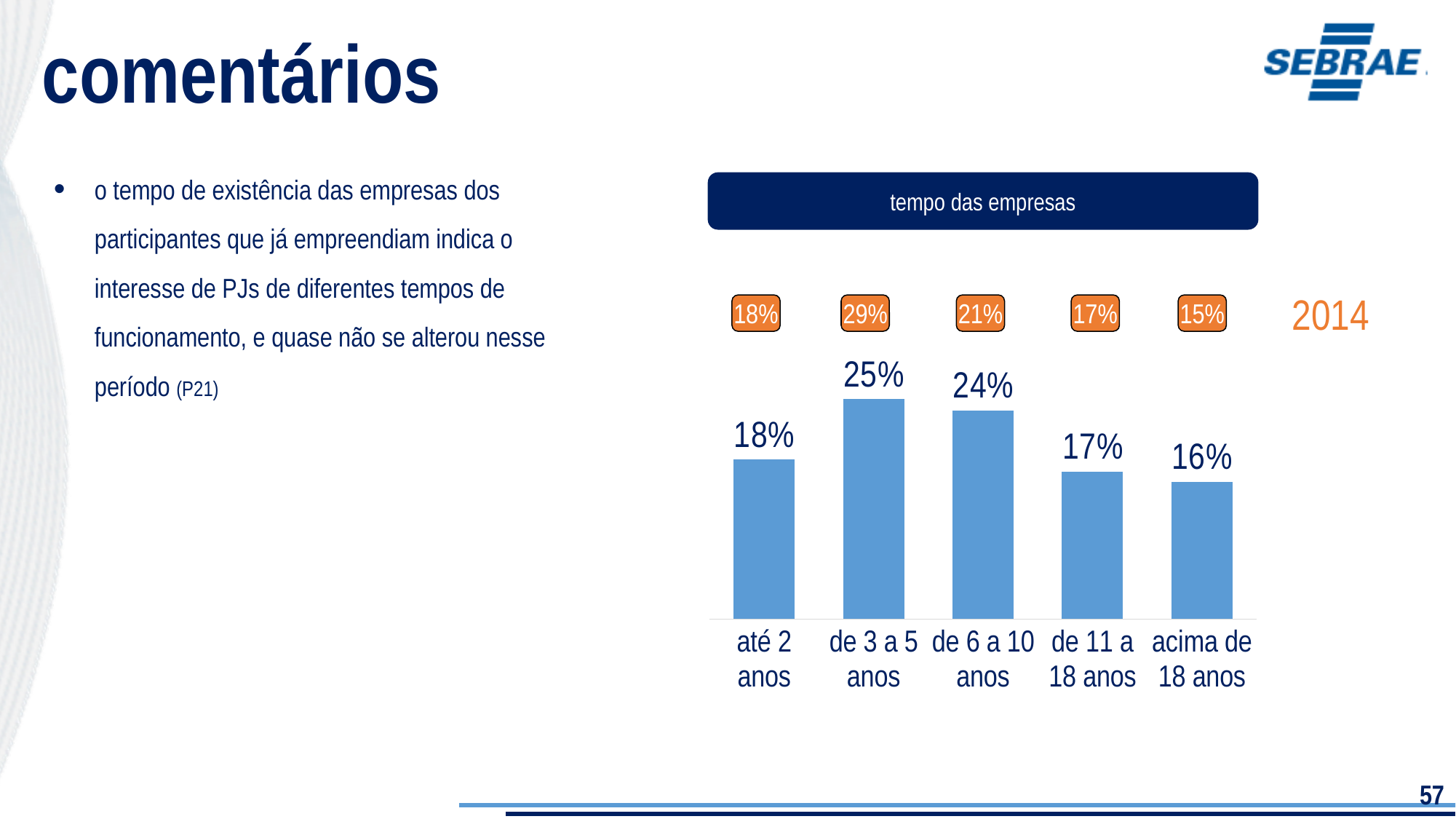
What is the title of the chart on the slide? tempo das empresas Which category has the highest value in the 'tempo das empresas' chart? de 3 a 5 anos What kind of chart is the 'tempo das empresas' chart? bar chart Which category has the lowest value in the 'tempo das empresas' chart? acima de 18 anos What is the difference between the values for 'de 3 a 5 anos' and 'de 11 a 18 anos' in the 'tempo das empresas' chart? 8% In the 'tempo das empresas' chart, which is larger: the value for 'de 6 a 10 anos' or the value for 'até 2 anos'? de 6 a 10 anos What is the value for 'até 2 anos' in the 'tempo das empresas' chart? 18% In the 'tempo das empresas' chart, what 2014 value is shown in the orange box above 'acima de 18 anos'? 15% In the 'tempo das empresas' chart, what 2014 value is shown in the orange box above 'de 3 a 5 anos'? 29% What is the value for 'acima de 18 anos' in the 'tempo das empresas' chart? 16% How many categories are shown in the 'tempo das empresas' chart? 5 What is the value for 'de 3 a 5 anos' in the 'tempo das empresas' chart? 25%